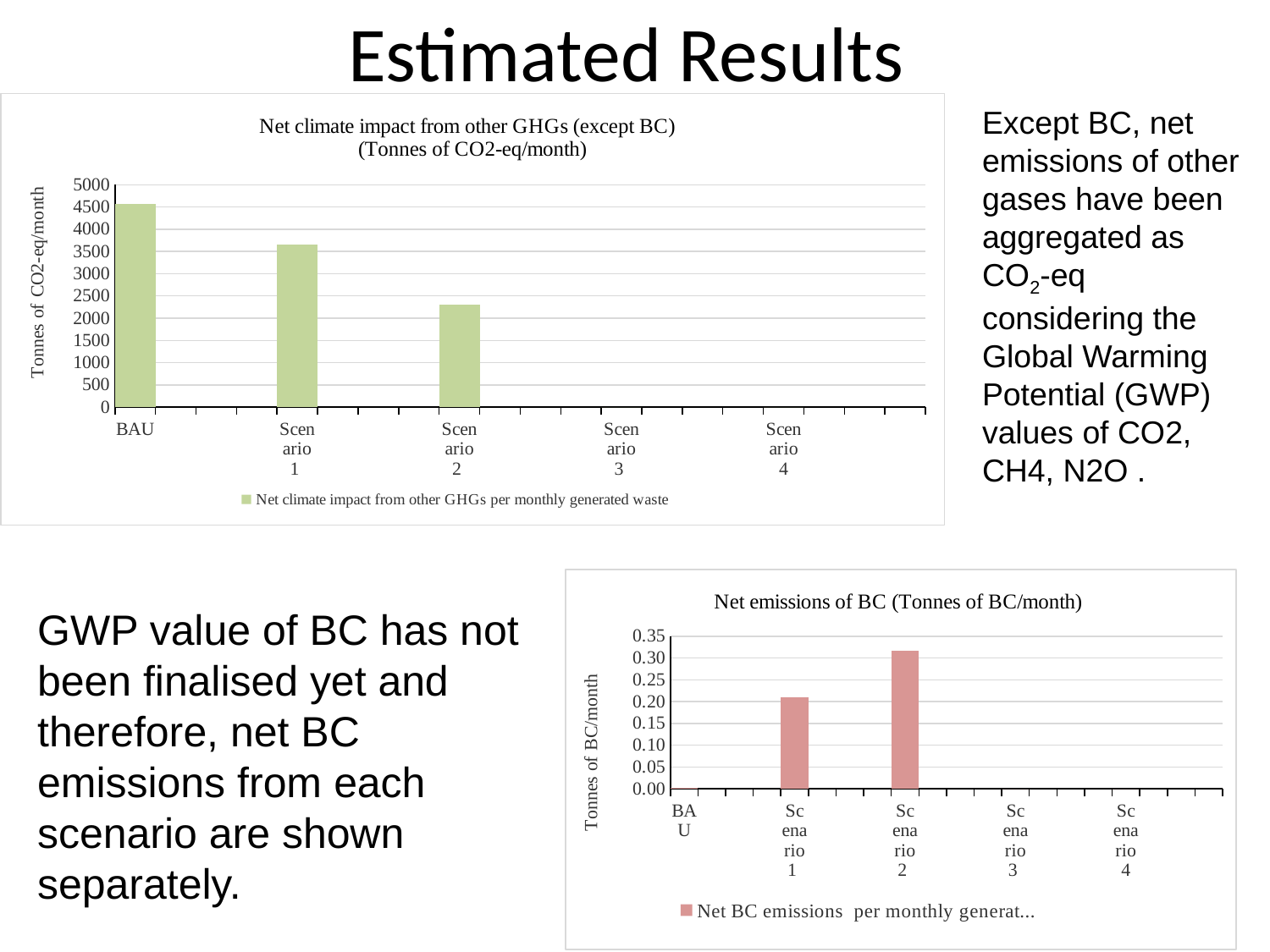
In the top chart, 'Net climate impact from other GHGs (except BC)', how many categories are shown on the x axis? 5 In the bottom chart, 'Net emissions of BC (Tonnes of BC/month)', how many series does the legend list? 1 In the top chart, 'Net climate impact from other GHGs (except BC)', is the value for BAU greater or less than 4000? greater In the top chart, 'Net climate impact from other GHGs (except BC)', which is larger, the value for Scenario 1 or the value for Scenario 2? Scenario 1 In the top chart, 'Net climate impact from other GHGs (except BC)', is the value for Scenario 2 greater or less than 2500? less In the top chart, 'Net climate impact from other GHGs (except BC)', what is the y-axis label? Tonnes of CO2-eq/month In the bottom chart, 'Net emissions of BC (Tonnes of BC/month)', which category has the highest value? Scenario 2 In the top chart, 'Net climate impact from other GHGs (except BC)', what kind of chart is shown? bar chart In the top chart, 'Net climate impact from other GHGs (except BC)', which category has the highest value? BAU In the bottom chart, 'Net emissions of BC (Tonnes of BC/month)', is the value for Scenario 2 greater or less than 0.30? greater In the top chart, 'Net climate impact from other GHGs (except BC)', do the bar values rise or fall from BAU to Scenario 2? fall